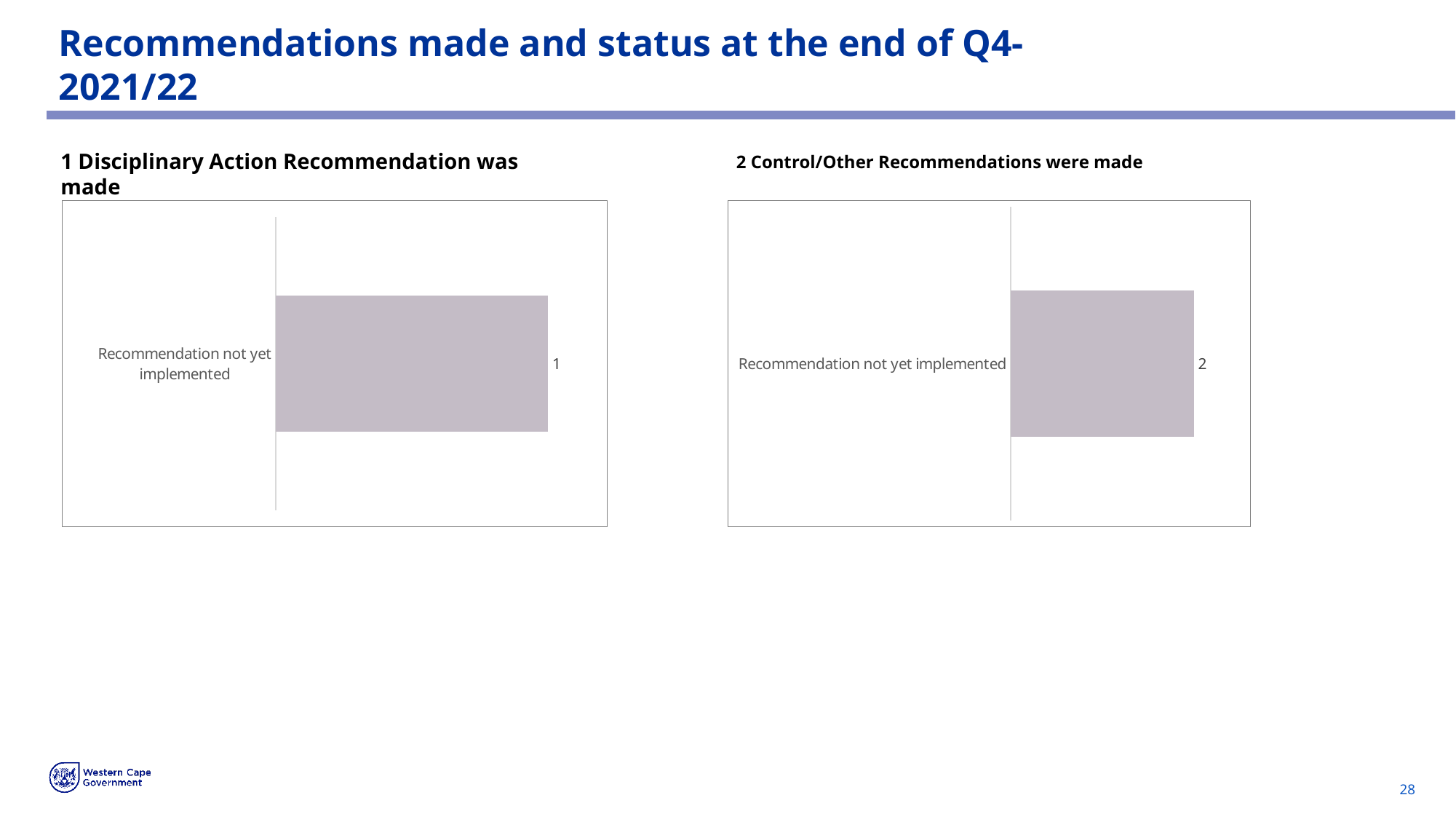
What is the category label shown in the left chart? Recommendation not yet implemented What is the difference between the 'Recommendation not yet implemented' value in the right chart and the one in the left chart? 1 What is the title above the right chart? 2 Control/Other Recommendations were made In the right chart (2 Control/Other Recommendations were made), what is the value for 'Recommendation not yet implemented'? 2 In the left chart (1 Disciplinary Action Recommendation was made), what is the value for 'Recommendation not yet implemented'? 1 How many categories are shown in the left chart (1 Disciplinary Action Recommendation was made)? 1 What kind of chart is the right chart on the slide? Bar chart What kind of chart is the left chart on the slide? Bar chart How many categories are shown in the right chart (2 Control/Other Recommendations were made)? 1 Which chart shows the larger value for 'Recommendation not yet implemented', the left chart or the right chart? The right chart